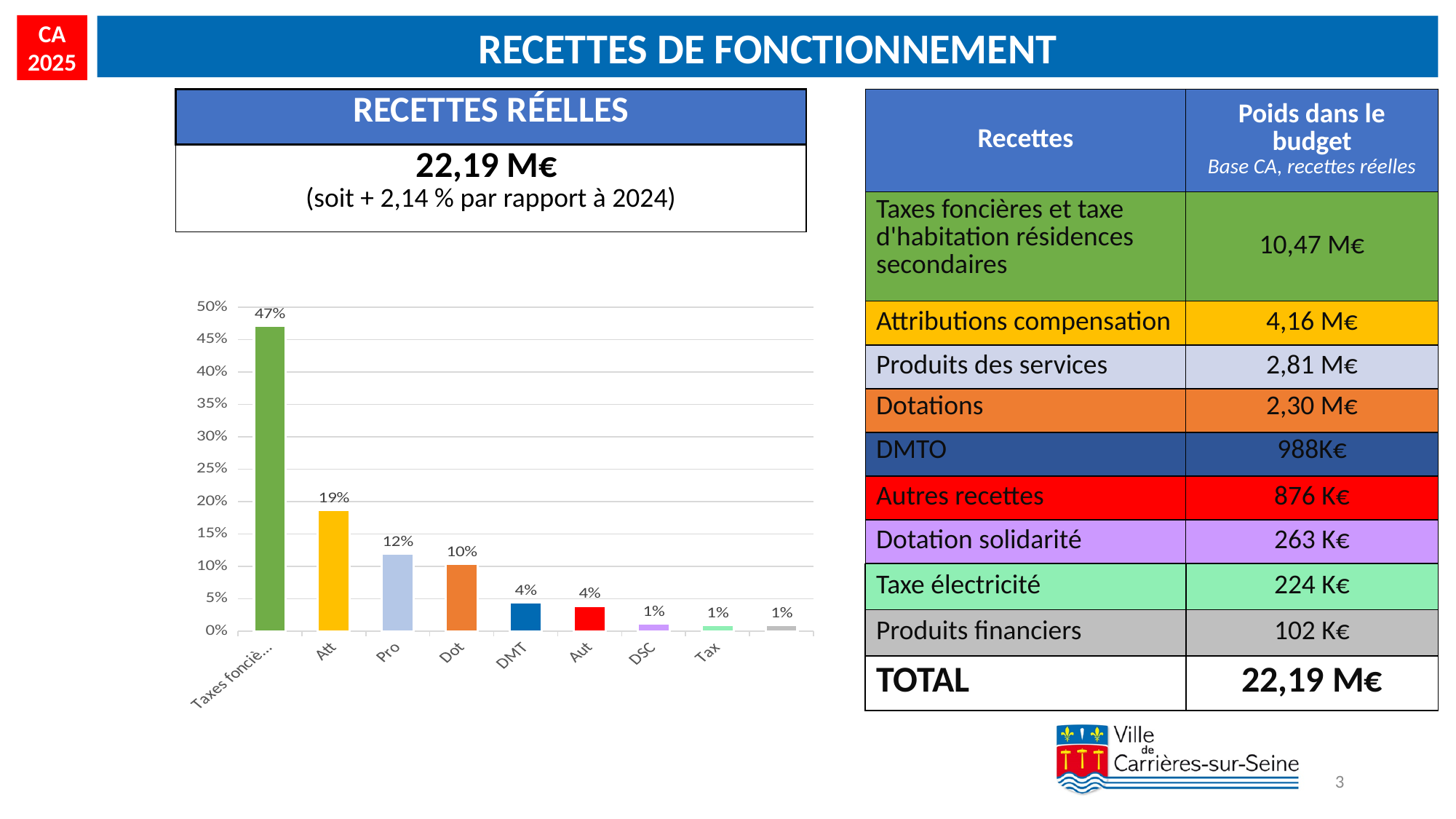
Which is larger, the Pro bar or the Dot bar? Pro What type of chart is shown on the slide? bar chart Do the bar values rise or fall from left to right along the x axis? fall What is the difference between the highest bar (47%) and the Att bar? 28% What is the difference between the Att bar and the Pro bar? 7% Which category has the highest bar in the chart? Taxes fonciè... What is the value shown for the Att bar? 19% What is the value shown for the DMT bar? 4% What is the value shown for the Dot bar? 10% What is the value shown for the DSC bar? 1% How many bars are plotted in the chart? 9 What is the value shown for the Pro bar? 12%